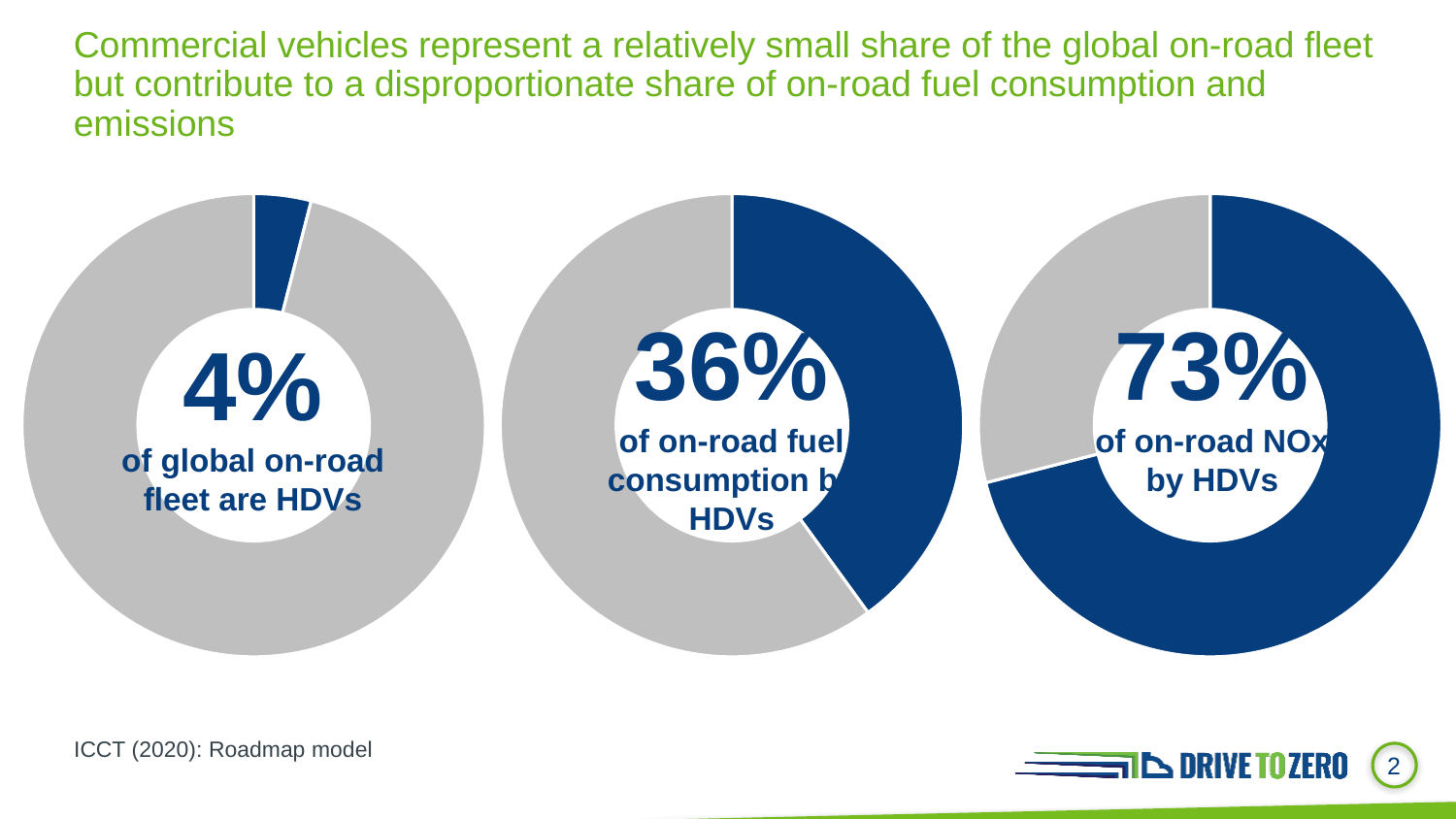
What is the difference between the HDV share of on-road NOx (right chart) and the HDV share of on-road fuel consumption (middle chart)? 37 percentage points In the left chart, what share of the global on-road fleet is represented by the grey (non-HDV) portion? 96% Which is larger: the HDV share of on-road fuel consumption (middle chart) or the HDV share of the global on-road fleet (left chart)? On-road fuel consumption In the left chart, what percentage of the global on-road fleet are HDVs? 4% Across the three charts, which measure shows the smallest HDV share? Global on-road fleet (4%) What kind of chart is used for each of the three figures on the slide? Donut (pie) chart How many charts are shown on the slide? 3 Across the three charts, which measure shows the largest HDV share? On-road NOx (73%) What colour is used for the HDV portion in each of the three charts? Dark blue In the middle chart, what percentage of on-road fuel consumption is by HDVs? 36% In the right chart, what percentage of on-road NOx is by HDVs? 73% What is the difference between the HDV share of on-road fuel consumption (middle chart) and the HDV share of the global on-road fleet (left chart)? 32 percentage points